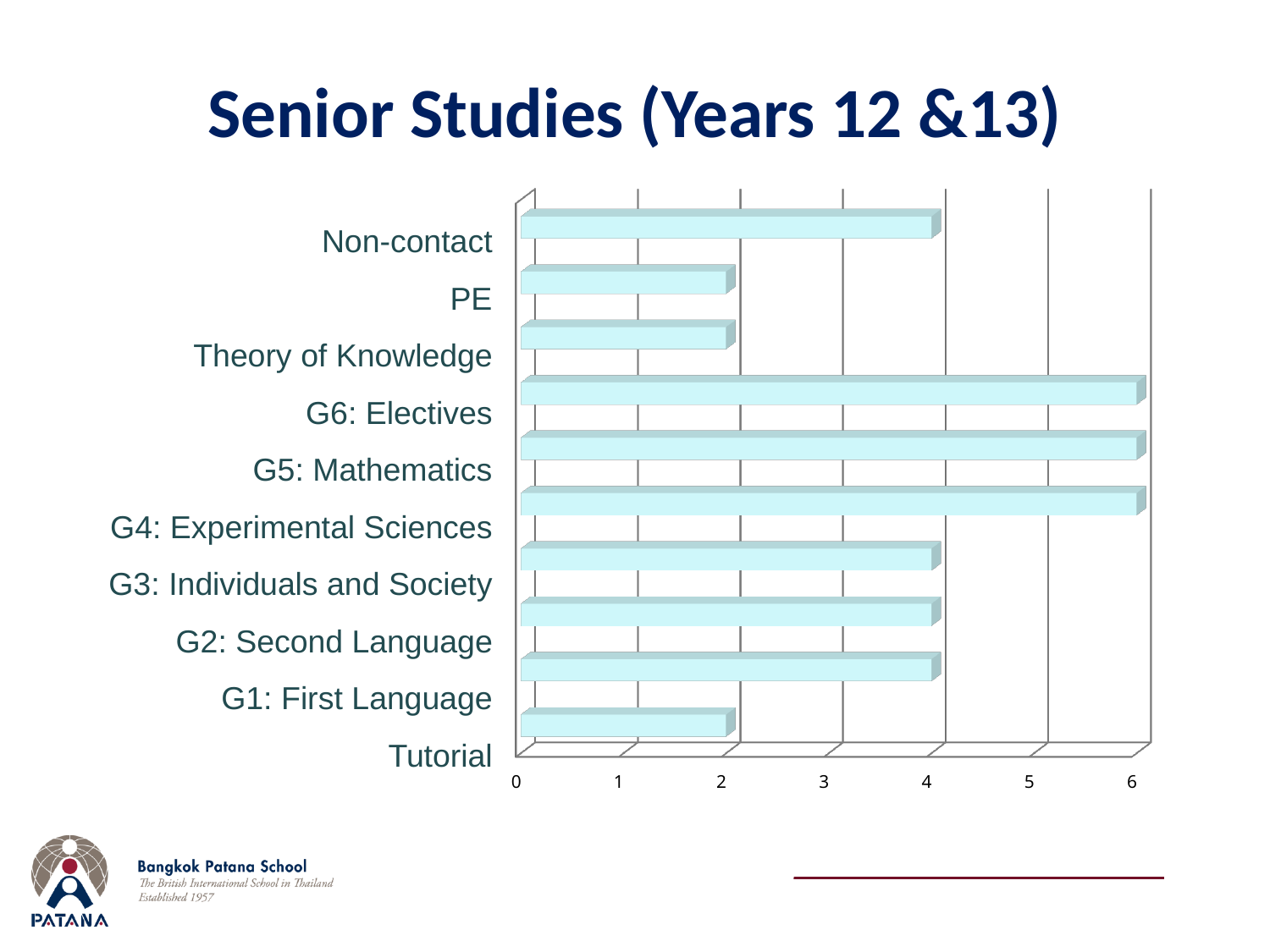
Which is larger, the value for G5: Mathematics or the value for PE? G5: Mathematics How many categories are plotted in the chart? 10 What is the value for Non-contact? 4 What is the value for G6: Electives? 6 What is the value for Tutorial? 2 Is the value for G4: Experimental Sciences greater or less than 5? greater What kind of chart is shown on the slide? bar chart Which is larger, the value for G1: First Language or the value for Tutorial? G1: First Language What is the value for Theory of Knowledge? 2 What is the difference between the value for G6: Electives and the value for G3: Individuals and Society? 2 Is the value for PE greater or less than 3? less What is the title of the chart on the slide? Senior Studies (Years 12 &13)